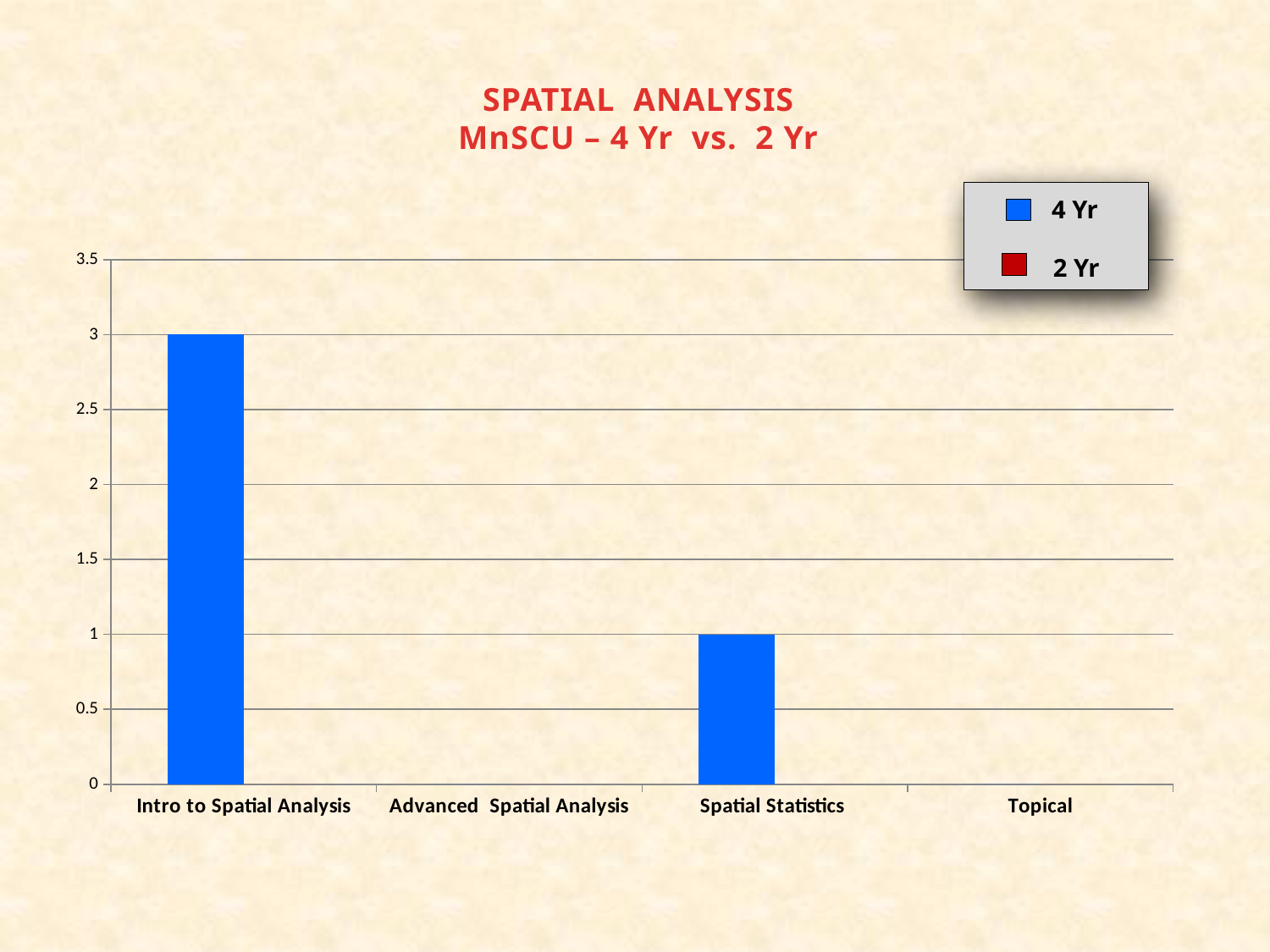
What is the title of the chart? SPATIAL ANALYSIS MnSCU – 4 Yr vs. 2 Yr Is the 4 Yr value for Intro to Spatial Analysis greater or less than 2? greater What is the difference between the 4 Yr values for Intro to Spatial Analysis and Spatial Statistics? 2 Is the 4 Yr value for Spatial Statistics greater or less than 2? less How many categories are shown on the x axis? 4 What colour represents the 4 Yr series in the legend? blue What is the 4 Yr value for Intro to Spatial Analysis? 3 What is the 4 Yr value for Spatial Statistics? 1 How many series does the legend list? 2 What kind of chart is shown on the slide? bar chart Which has a larger 4 Yr value, Intro to Spatial Analysis or Spatial Statistics? Intro to Spatial Analysis Which category has the highest 4 Yr value? Intro to Spatial Analysis